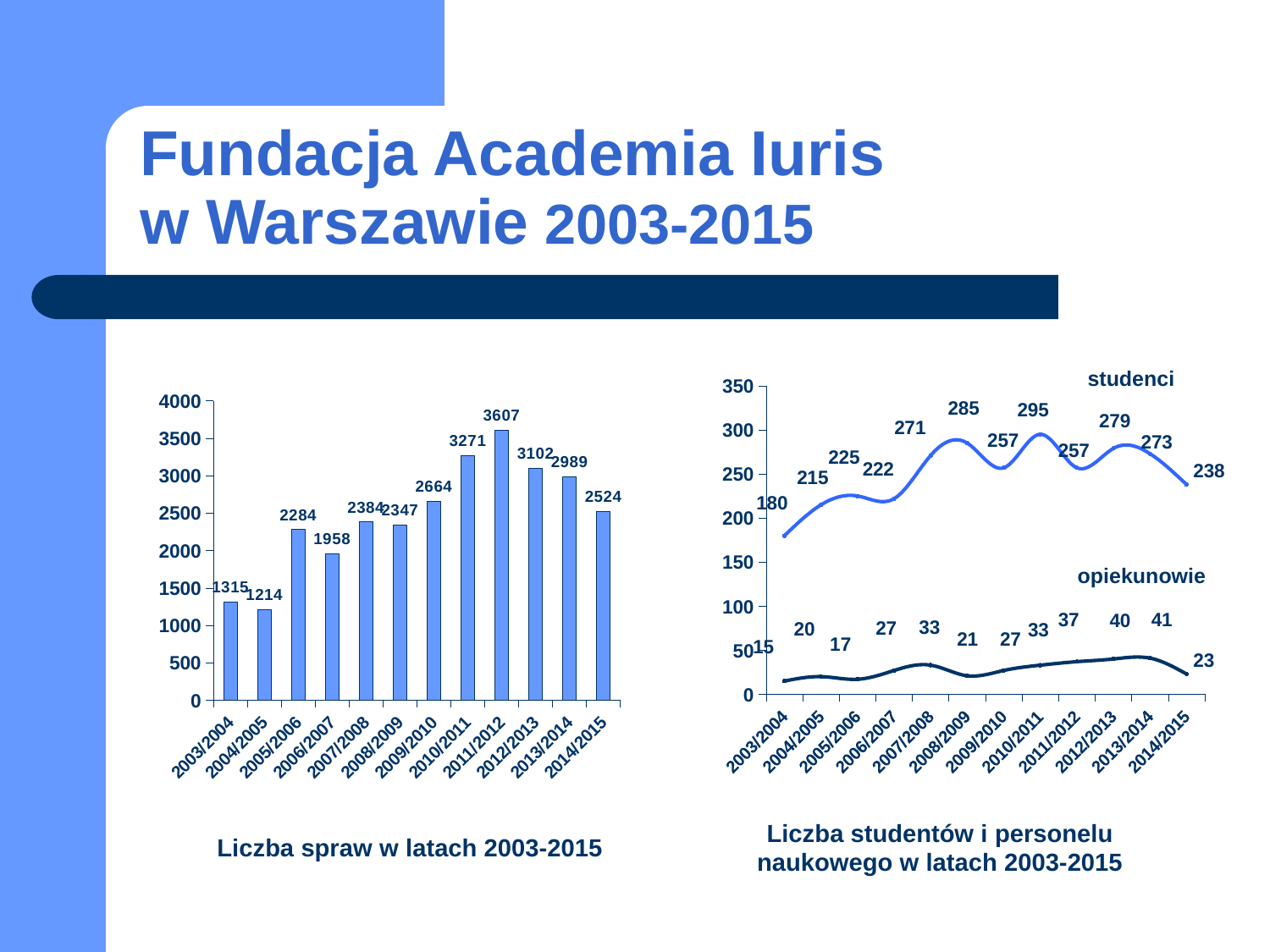
In the left chart (Liczba spraw w latach 2003-2015), which year has the lowest value? 2004/2005 In the right chart (Liczba studentów i personelu naukowego), what is the value for studenci in 2010/2011? 295 What type of chart is the left chart (Liczba spraw w latach 2003-2015)? bar chart What type of chart is the right chart (Liczba studentów i personelu naukowego)? line chart In the left chart (Liczba spraw w latach 2003-2015), how many years are shown on the x axis? 12 In the left chart (Liczba spraw w latach 2003-2015), what is the value for 2011/2012? 3607 In the right chart (Liczba studentów i personelu naukowego), what is the value for opiekunowie in 2013/2014? 41 In the right chart (Liczba studentów i personelu naukowego), what are the two series labelled? studenci and opiekunowie In the right chart (Liczba studentów i personelu naukowego), which year has the highest value for studenci? 2010/2011 In the left chart (Liczba spraw w latach 2003-2015), what is the difference between the values for 2011/2012 and 2014/2015? 1083 In the right chart (Liczba studentów i personelu naukowego), what is the difference between studenci and opiekunowie in 2014/2015? 215 In the left chart (Liczba spraw w latach 2003-2015), which is larger, the value for 2005/2006 or 2006/2007? 2005/2006